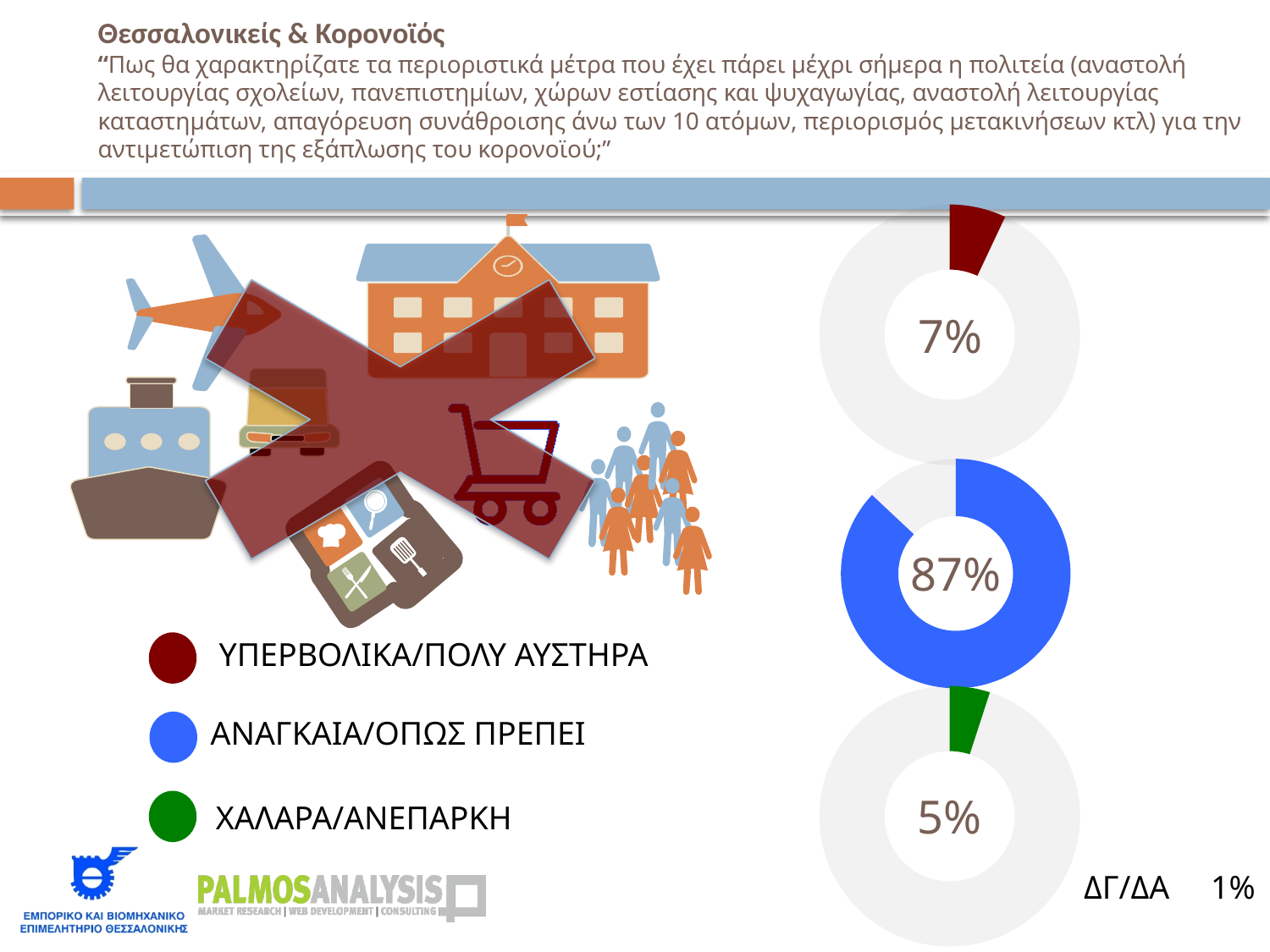
What colour represents the ΑΝΑΓΚΑΙΑ/ΟΠΩΣ ΠΡΕΠΕΙ category in the legend? Blue What is the difference in percentage points between ΑΝΑΓΚΑΙΑ/ΟΠΩΣ ΠΡΕΠΕΙ and ΥΠΕΡΒΟΛΙΚΑ/ΠΟΛΥ ΑΥΣΤΗΡΑ? 80 What percentage of respondents characterised the measures as ΧΑΛΑΡΑ/ΑΝΕΠΑΡΚΗ (bottom donut chart)? 5% Which response category has the highest percentage across the donut charts? ΑΝΑΓΚΑΙΑ/ΟΠΩΣ ΠΡΕΠΕΙ What percentage of respondents characterised the measures as ΑΝΑΓΚΑΙΑ/ΟΠΩΣ ΠΡΕΠΕΙ (middle donut chart)? 87% What type of chart is used to display the percentages on the right of the slide? Donut (pie) chart What percentage is shown for ΔΓ/ΔΑ on the slide? 1% Which is larger: the percentage for ΥΠΕΡΒΟΛΙΚΑ/ΠΟΛΥ ΑΥΣΤΗΡΑ or for ΧΑΛΑΡΑ/ΑΝΕΠΑΡΚΗ? ΥΠΕΡΒΟΛΙΚΑ/ΠΟΛΥ ΑΥΣΤΗΡΑ What is the difference in percentage points between ΥΠΕΡΒΟΛΙΚΑ/ΠΟΛΥ ΑΥΣΤΗΡΑ and ΧΑΛΑΡΑ/ΑΝΕΠΑΡΚΗ? 2 Which of the three legend categories has the lowest percentage in the donut charts? ΧΑΛΑΡΑ/ΑΝΕΠΑΡΚΗ How many donut charts are shown on the slide? 3 What percentage of respondents characterised the restrictive measures as ΥΠΕΡΒΟΛΙΚΑ/ΠΟΛΥ ΑΥΣΤΗΡΑ (top donut chart)? 7%